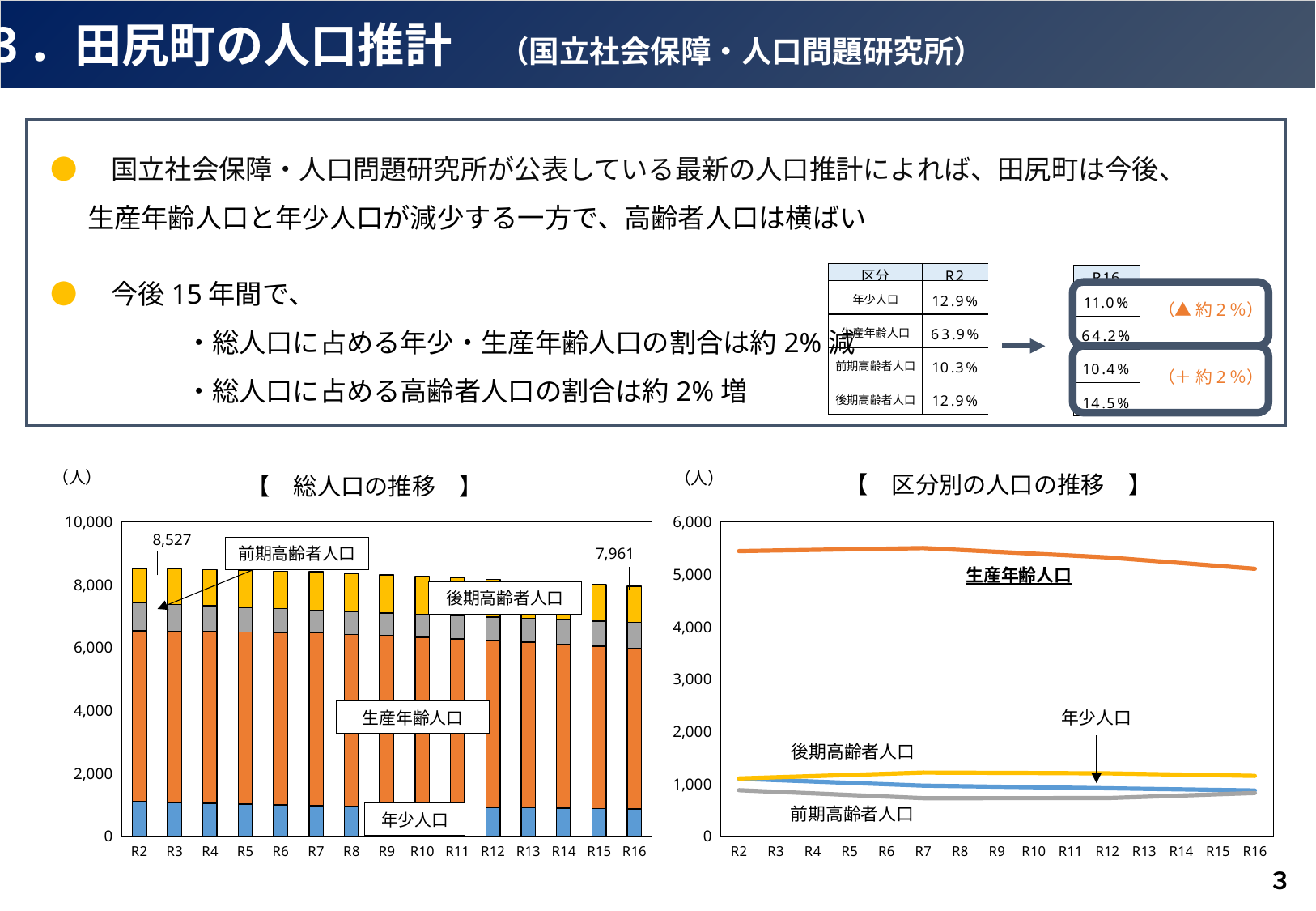
What kind of chart is the 区分別の人口の推移 chart on the right? Line chart In the 区分別の人口の推移 chart, is the value for 生産年齢人口 at R2 greater or less than 5,000? greater In the 総人口の推移 chart, what is the total population value labelled for R16? 7,961 In the 区分別の人口の推移 chart, how many population categories (lines) are plotted? 4 In the 総人口の推移 chart, what is the total population value labelled for R2? 8,527 In the 総人口の推移 chart, which year has the larger labelled total, R2 or R16? R2 In the 総人口の推移 chart, how many years (categories) are shown on the x axis? 15 In the 区分別の人口の推移 chart, which population category has the highest values? 生産年齢人口 In the 総人口の推移 chart, does the total population rise or fall from R2 to R16? Fall In the 区分別の人口の推移 chart, is the value for 前期高齢者人口 at R7 greater or less than 1,000? less What kind of chart is the 総人口の推移 chart on the left? Stacked bar chart In the 総人口の推移 chart, what is the difference between the labelled totals for R2 and R16? 566